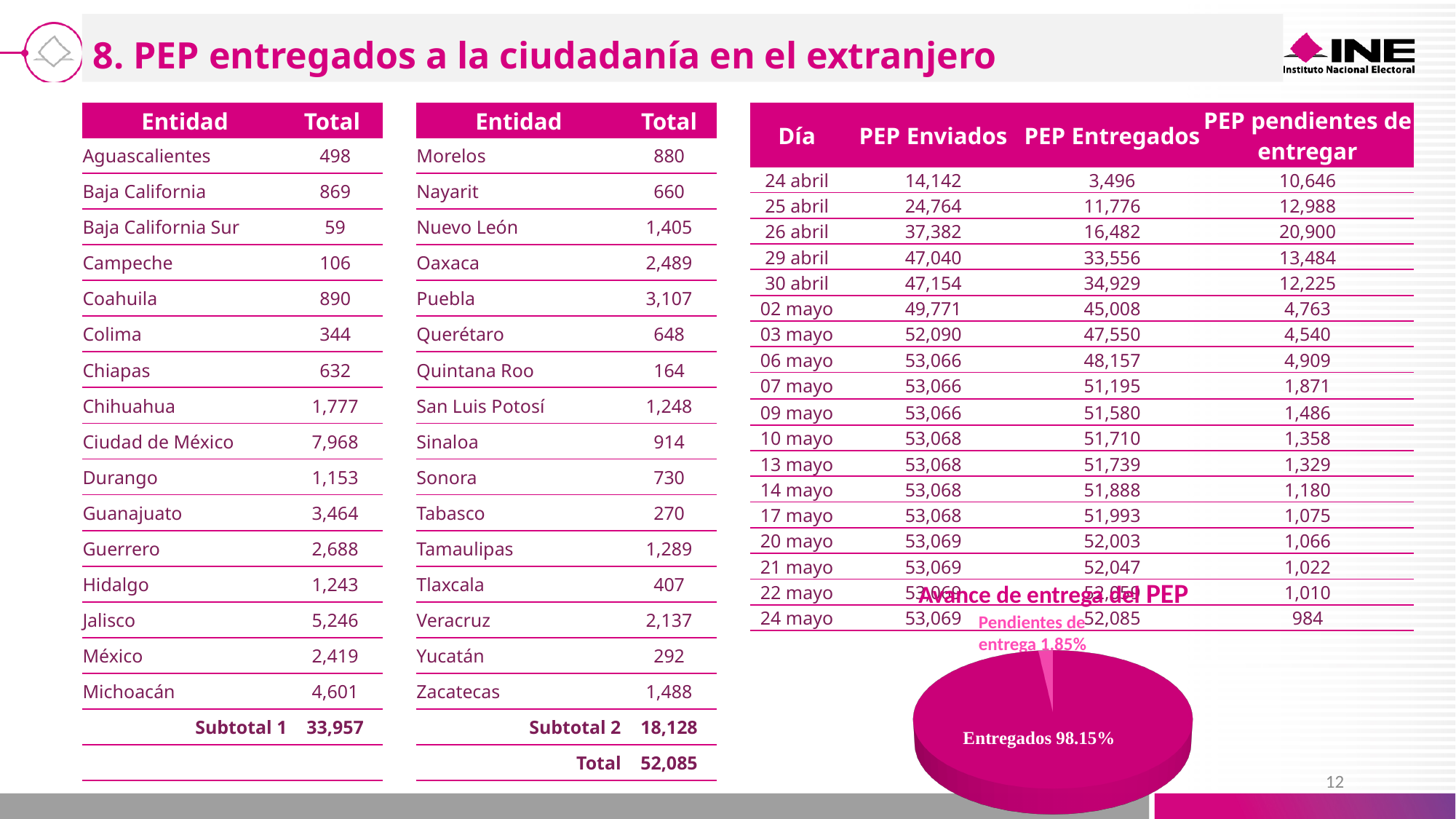
What is the difference in percentage points between the Entregados and Pendientes de entrega slices? 96.30 What kind of chart is shown on the slide? Pie chart Which slice of the pie chart is the largest? Entregados Which is larger in the pie chart, Entregados or Pendientes de entrega? Entregados How many slices does the pie chart have? 2 What share of the pie does Entregados represent? 98.15% Which slice of the pie chart is the smallest? Pendientes de entrega What share of the pie does Pendientes de entrega represent? 1.85% What is the title of the pie chart? Avance de entrega del PEP What is the combined share of the two slices in the pie chart? 100%